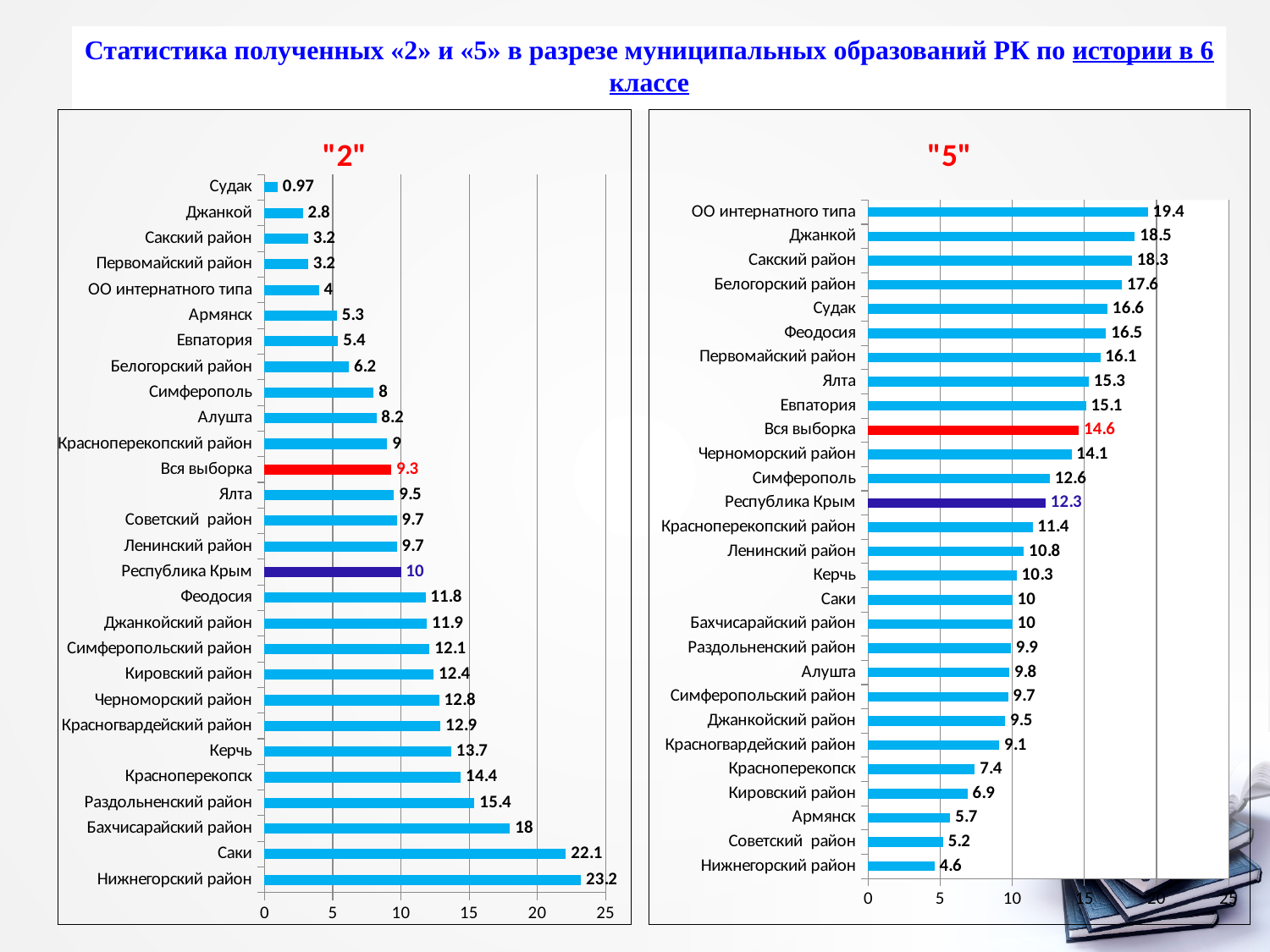
In the "5" chart, what is the value for ОО интернатного типа? 19.4 In the "2" chart, which category has the lowest value? Судак In the "5" chart, what is the difference between the values for Джанкой and Республика Крым? 6.2 In the "2" chart, what colour is the bar for Вся выборка? Red In the "5" chart, which is larger: the value for Ялта or the value for Симферополь? Ялта In the "2" chart, what is the difference between the values for Бахчисарайский район and Керчь? 4.3 In the "2" chart, which category has the highest value? Нижнегорский район In the "5" chart, which category has the lowest value? Нижнегорский район In the "2" chart, what is the value for Вся выборка? 9.3 How many categories are shown in the "5" chart? 28 In the "2" chart, what is the value for Саки? 22.1 What type of chart is the "2" chart? Bar chart